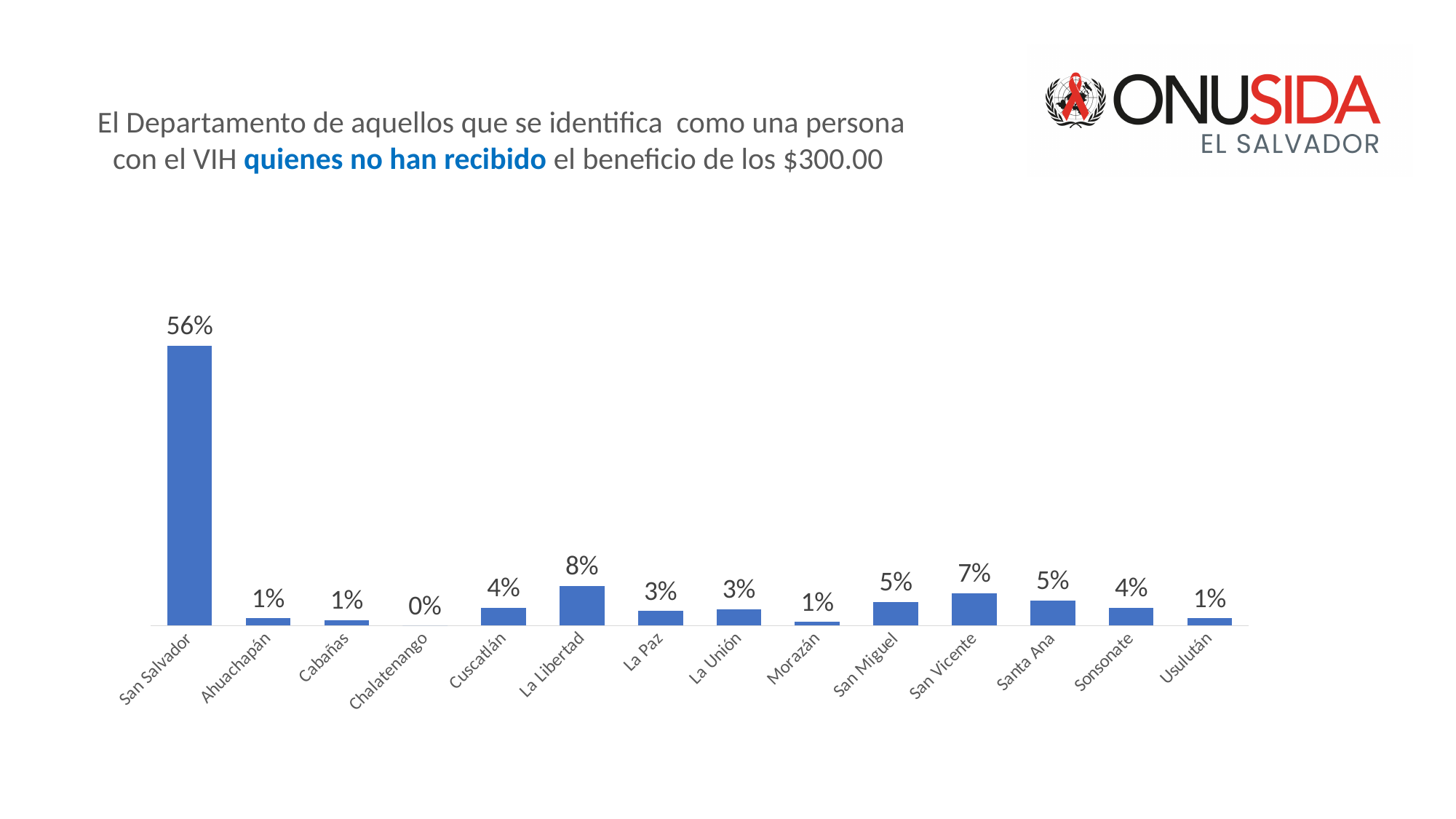
What is the value for La Libertad? 8% Which is larger, the value for San Miguel or the value for La Paz? San Miguel What is the value for San Salvador? 56% What is the value for San Vicente? 7% What is the difference between the values for San Salvador and La Libertad? 48% What colour are the bars in the chart? Blue How many departments are shown on the x axis? 14 Which department has the highest value? San Salvador What is the difference between the values for San Vicente and Cuscatlán? 3% What kind of chart is shown on the slide? Bar chart What is the value for Chalatenango? 0% Which department has the lowest value? Chalatenango